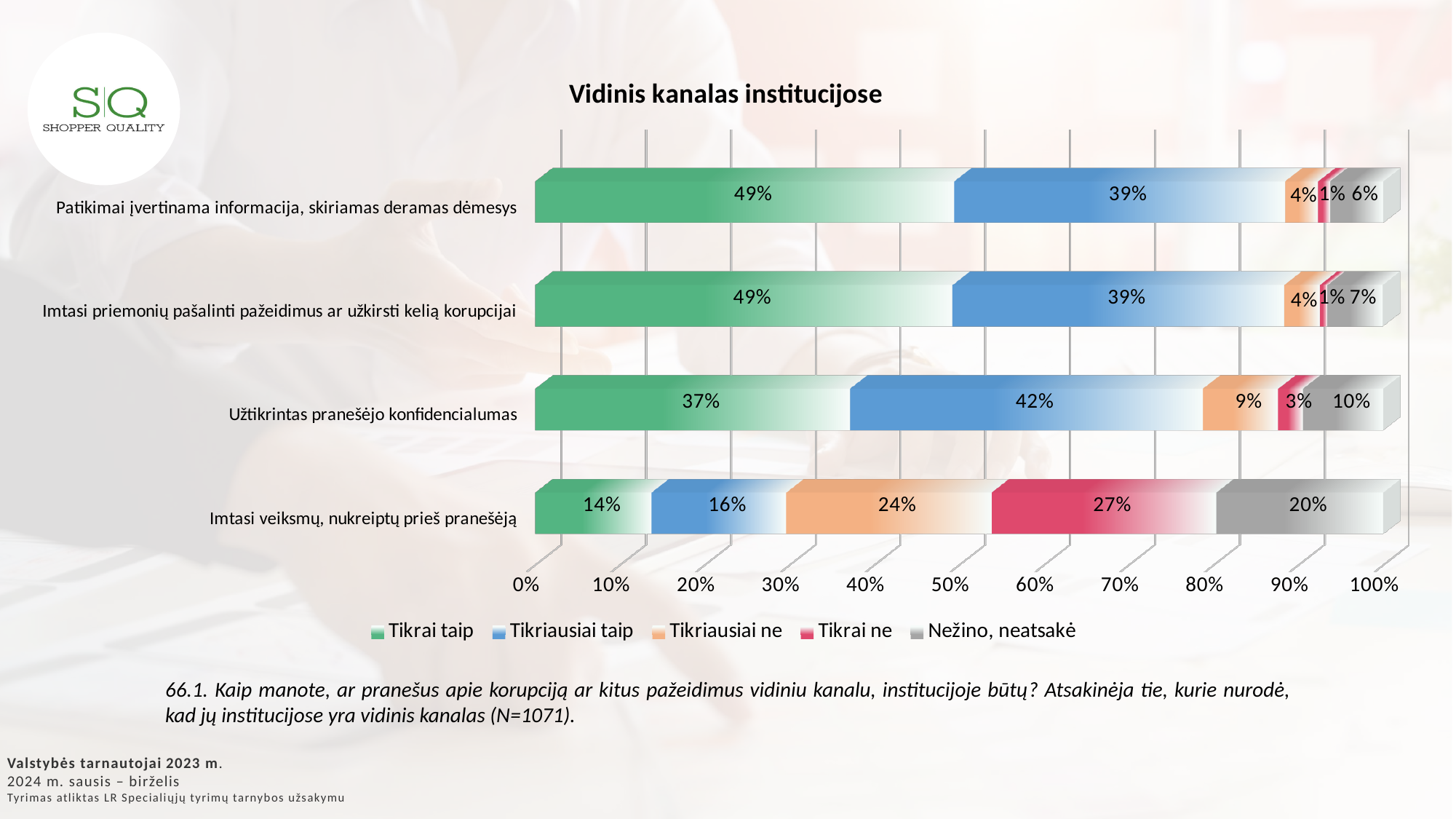
What kind of chart is shown on the slide? Stacked bar chart What is the 'Nežino, neatsakė' value for 'Imtasi priemonių pašalinti pažeidimus ar užkirsti kelią korupcijai'? 7% What is the combined 'Tikrai taip' and 'Tikriausiai taip' share for 'Patikimai įvertinama informacija, skiriamas deramas dėmesys'? 88% What is the 'Tikrai ne' value for 'Imtasi veiksmų, nukreiptų prieš pranešėją'? 27% Which category has the lowest 'Tikrai taip' value? Imtasi veiksmų, nukreiptų prieš pranešėją What is the 'Tikrai taip' value for 'Užtikrintas pranešėjo konfidencialumas'? 37% How many categories are plotted on the chart? 4 What is the title of the chart? Vidinis kanalas institucijose Which is larger for 'Imtasi veiksmų, nukreiptų prieš pranešėją': the 'Tikriausiai taip' value or the 'Nežino, neatsakė' value? Nežino, neatsakė What is the difference between the 'Tikriausiai ne' values for 'Imtasi veiksmų, nukreiptų prieš pranešėją' and 'Užtikrintas pranešėjo konfidencialumas'? 15% How many series does the legend list? 5 Which category has the highest 'Tikriausiai taip' value? Užtikrintas pranešėjo konfidencialumas